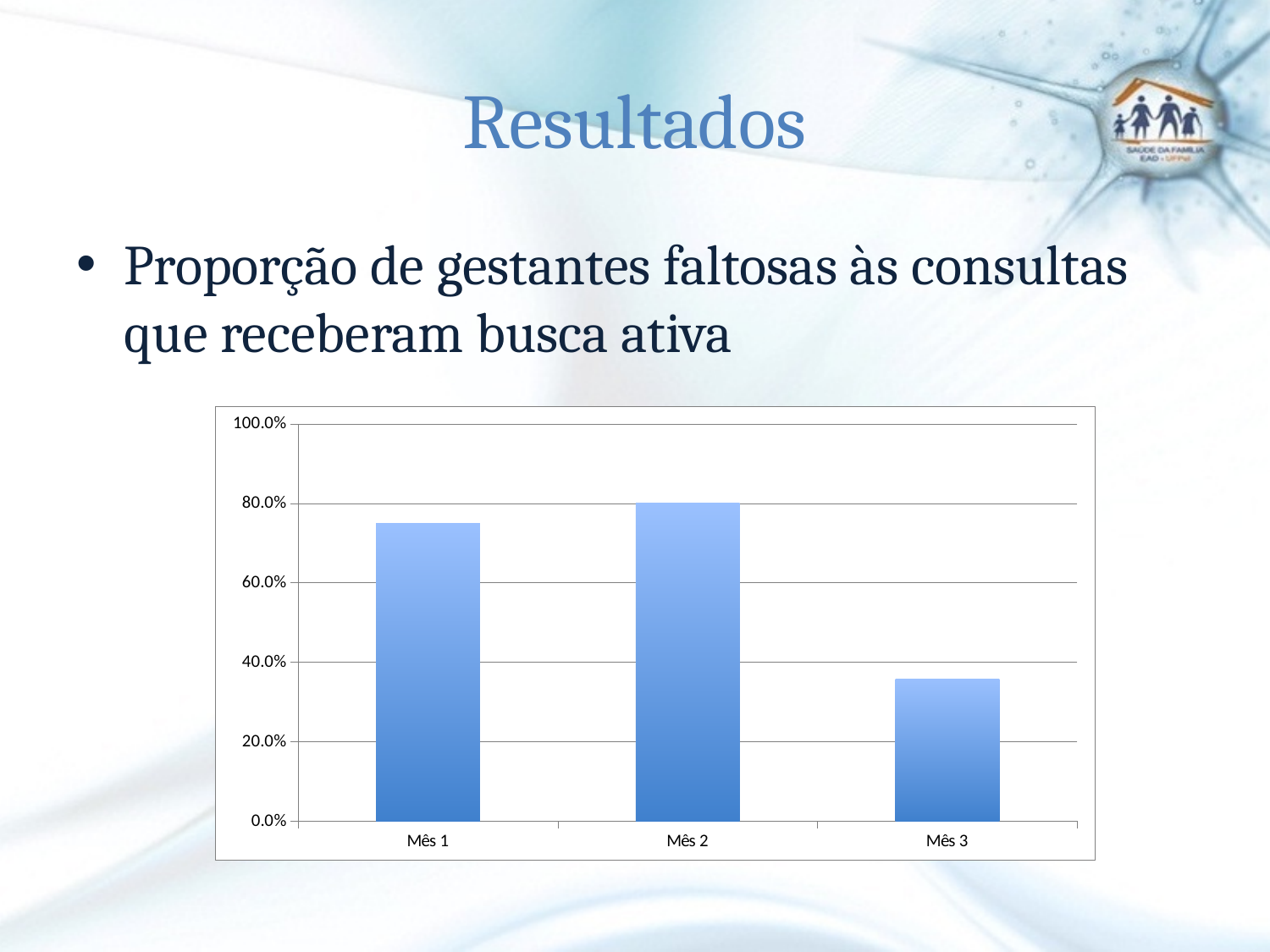
Is the value for Mês 1 greater or less than 60.0%? greater Which is larger, the value for Mês 1 or the value for Mês 3? Mês 1 How many categories are shown on the x axis of the chart? 3 Which month has the lowest value in the chart? Mês 3 What is the highest value shown on the y axis of the chart? 100.0% What is the label of the first category on the x axis? Mês 1 Which is larger, the value for Mês 2 or the value for Mês 1? Mês 2 Is the value for Mês 3 greater or less than 40.0%? less Is the value for Mês 1 greater or less than 80.0%? less Which month has the highest value in the chart? Mês 2 What kind of chart is shown on the slide? bar chart